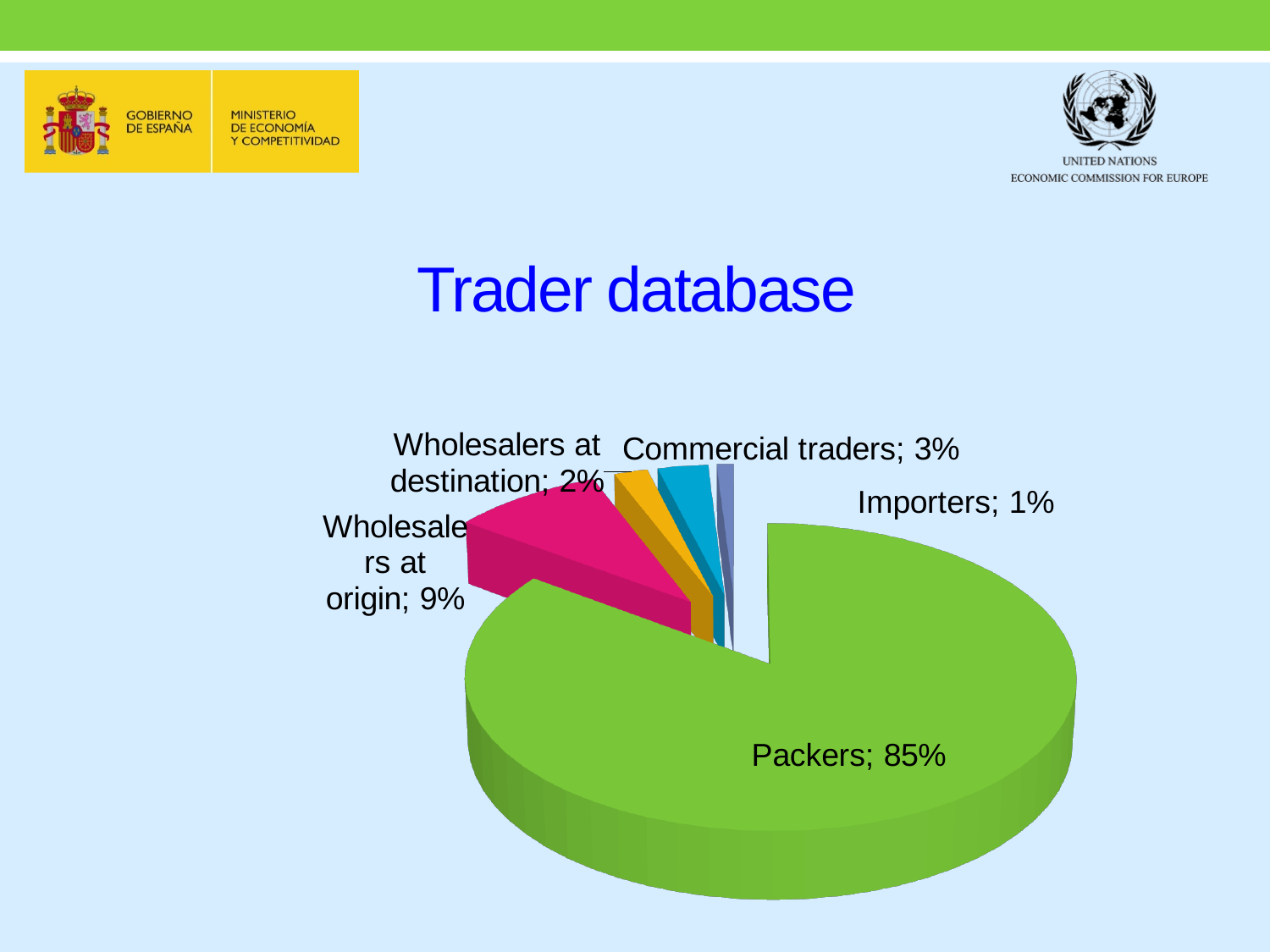
Which category has the smallest slice of the pie? Importers Which category has the largest slice of the pie? Packers What is the value for Wholesalers at origin? 9% Which is larger, the share of Commercial traders or the share of Wholesalers at destination? Commercial traders What is the difference between the shares of Packers and Wholesalers at origin? 76% What is the value for Importers? 1% What is the value for Commercial traders? 3% What share of the pie do Packers account for? 85% How many categories are shown in the pie chart? 5 What is the value for Wholesalers at destination? 2% What kind of chart is shown on the slide? pie chart What is the title of the slide containing the chart? Trader database